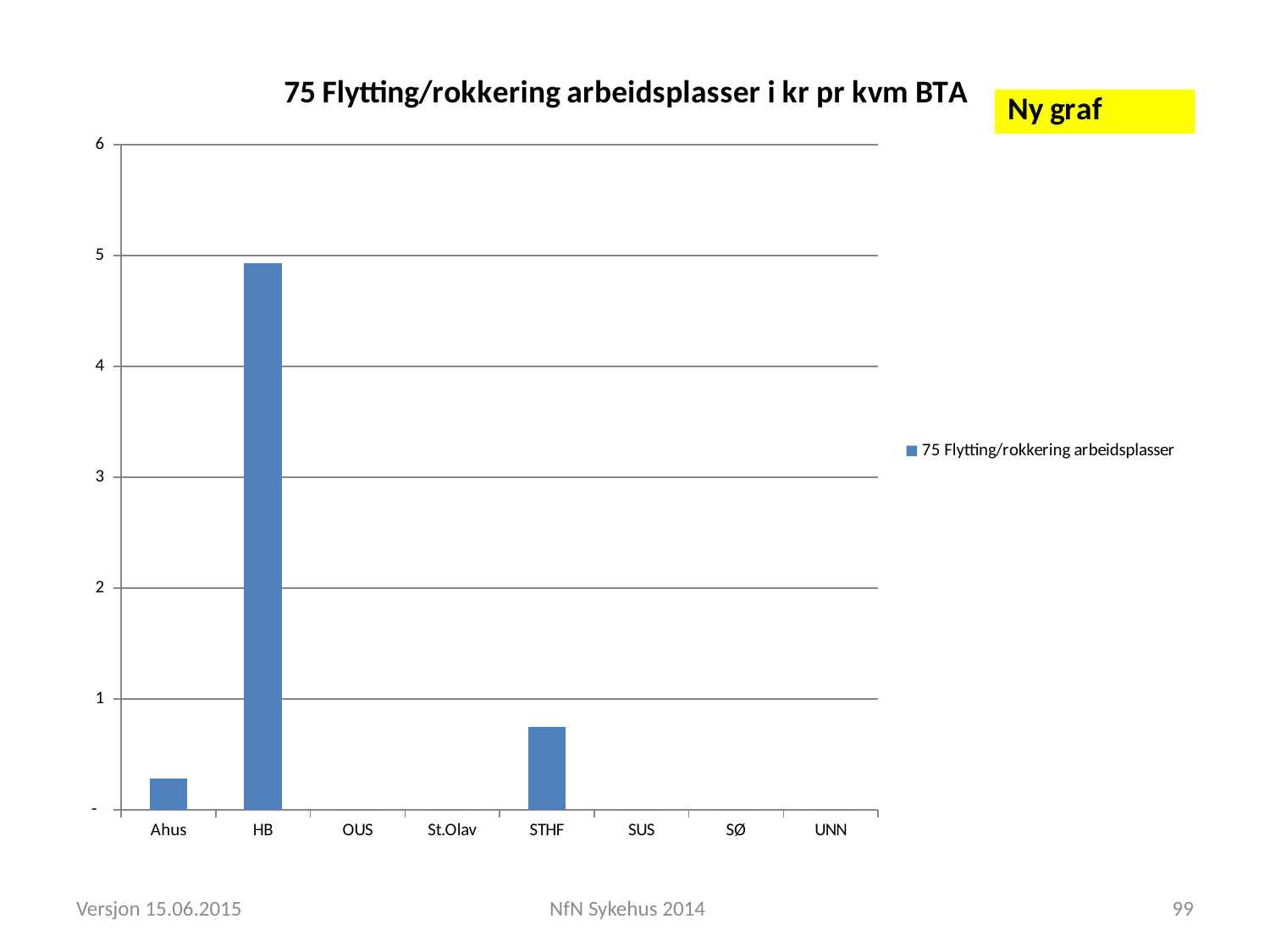
How many categories are shown on the x axis? 8 Is the value for STHF greater or less than 1? less Which category has the highest value? HB How many categories show a visible bar? 3 How many series does the legend list? 1 Which is larger, the value for STHF or the value for Ahus? STHF Is the value for Ahus greater or less than 1? less Is the value for HB greater or less than 4? greater Which is larger, the value for HB or the value for STHF? HB What kind of chart is shown on the slide? bar chart What is the title of the chart? 75 Flytting/rokkering arbeidsplasser i kr pr kvm BTA